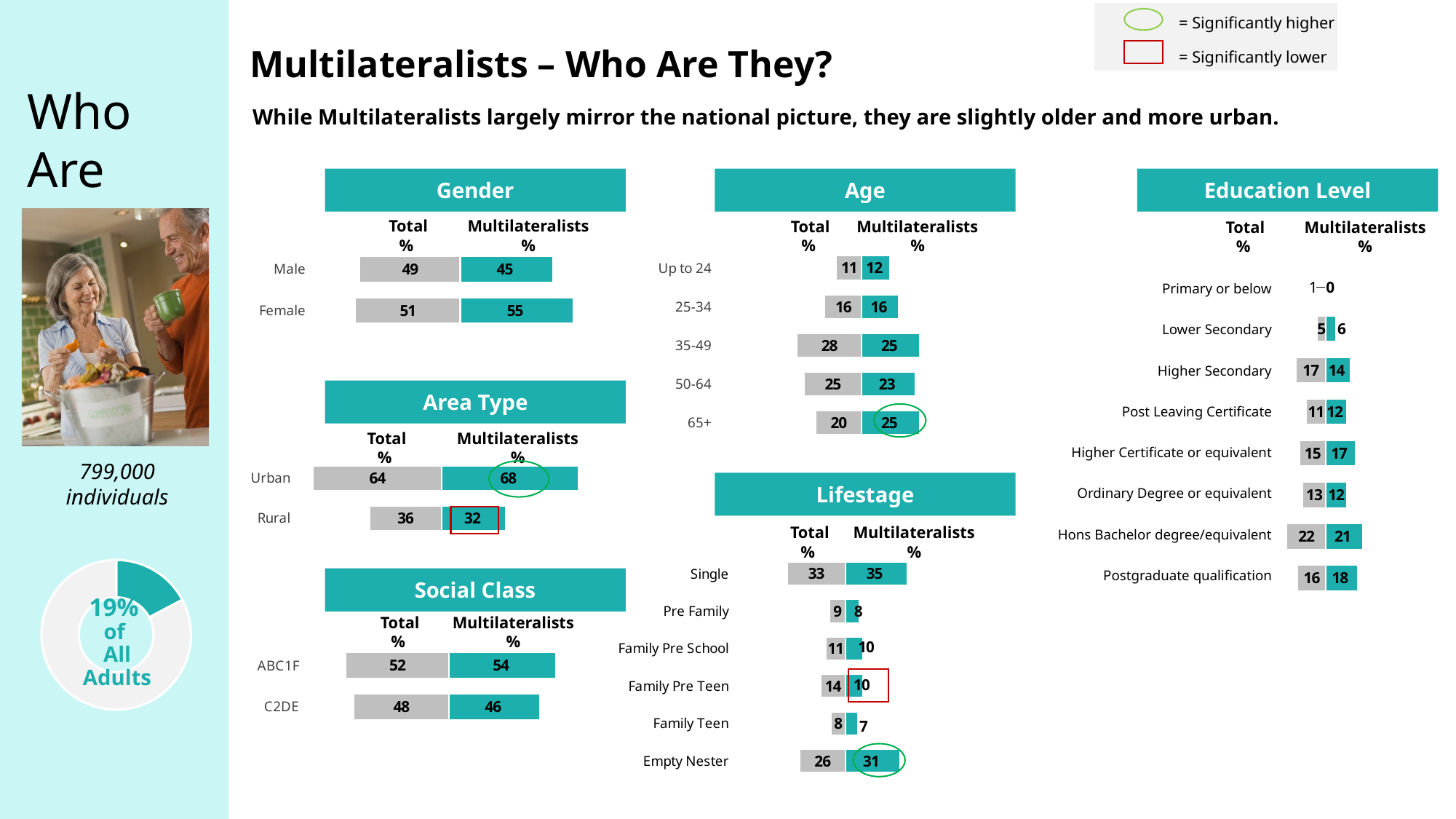
In the Education Level chart, what is the Multilateralists % for Hons Bachelor degree/equivalent? 21 In the Area Type chart, what is the difference between the Multilateralists % and the Total % for Urban? 4 In the Age chart, which age group has the highest Total %? 35-49 In the Area Type chart, what is the Total % for Urban? 64 What share of all adults does the donut chart on the left show for Multilateralists? 19% In the Gender chart, what is the Multilateralists % for Female? 55 In the Lifestage chart, what is the Total % for Empty Nester? 26 In the Social Class chart, which is larger for C2DE: the Total % or the Multilateralists %? Total % In the Age chart, what is the Multilateralists % for 65+? 25 In the Lifestage chart, which lifestage has the lowest Multilateralists %? Family Teen How many age groups are shown in the Age chart? 5 In the Education Level chart, which education level has the highest Total %? Hons Bachelor degree/equivalent